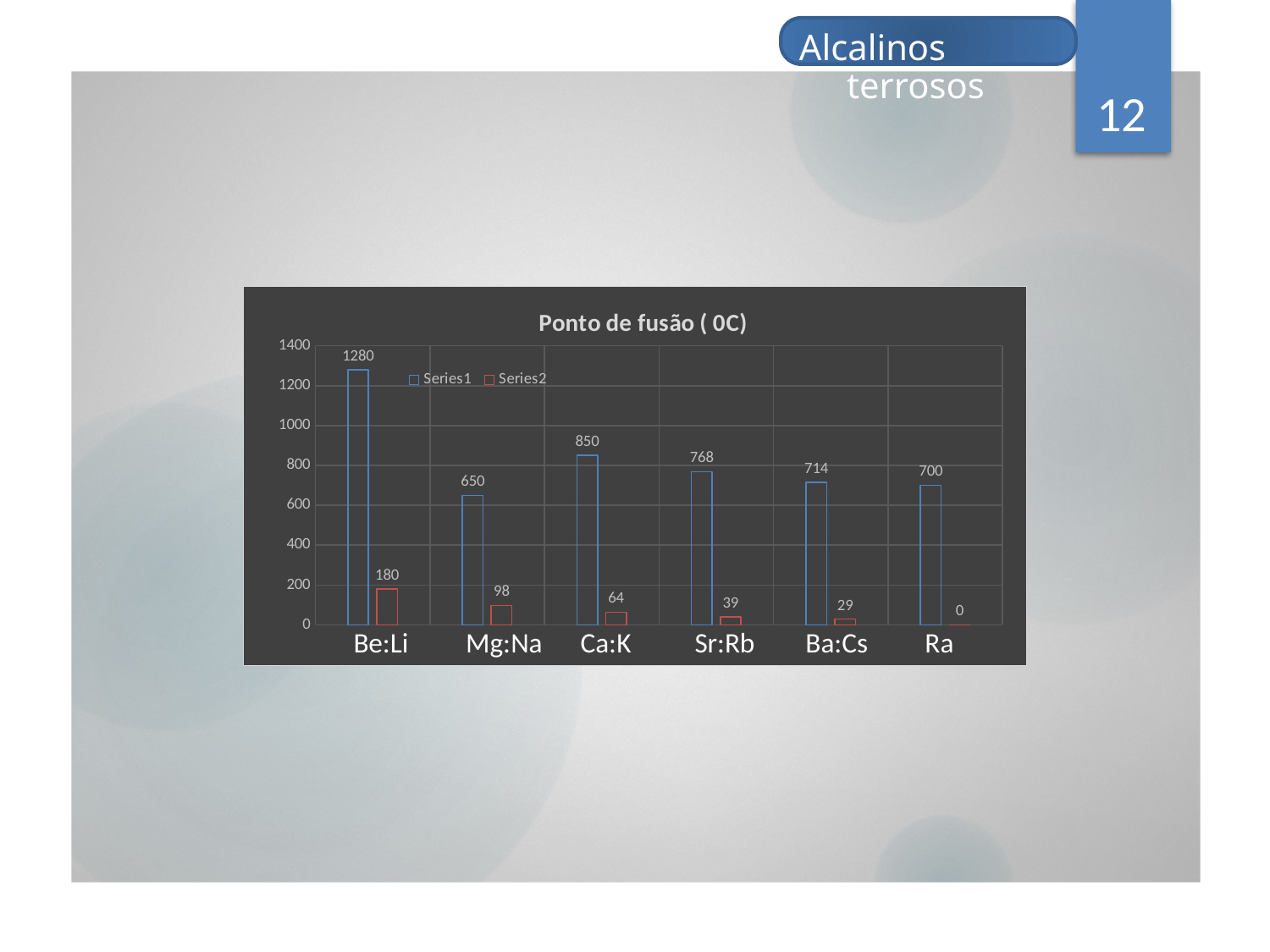
Which category has the highest Series1 value? Be:Li What kind of chart is shown? bar chart Which category has the lowest Series2 value? Ra What is the Series1 value for Ra? 700 What is the difference between the Series1 values for Ca:K and Sr:Rb? 82 What is the Series1 value for Be:Li? 1280 How many categories are shown on the x axis? 6 What is the title of the chart? Ponto de fusão ( 0C) How many series does the legend list? 2 What is the Series2 value for Mg:Na? 98 Which is larger, the Series1 value for Ba:Cs or for Ra? Ba:Cs Is the Series1 value for Mg:Na greater or less than 800? less